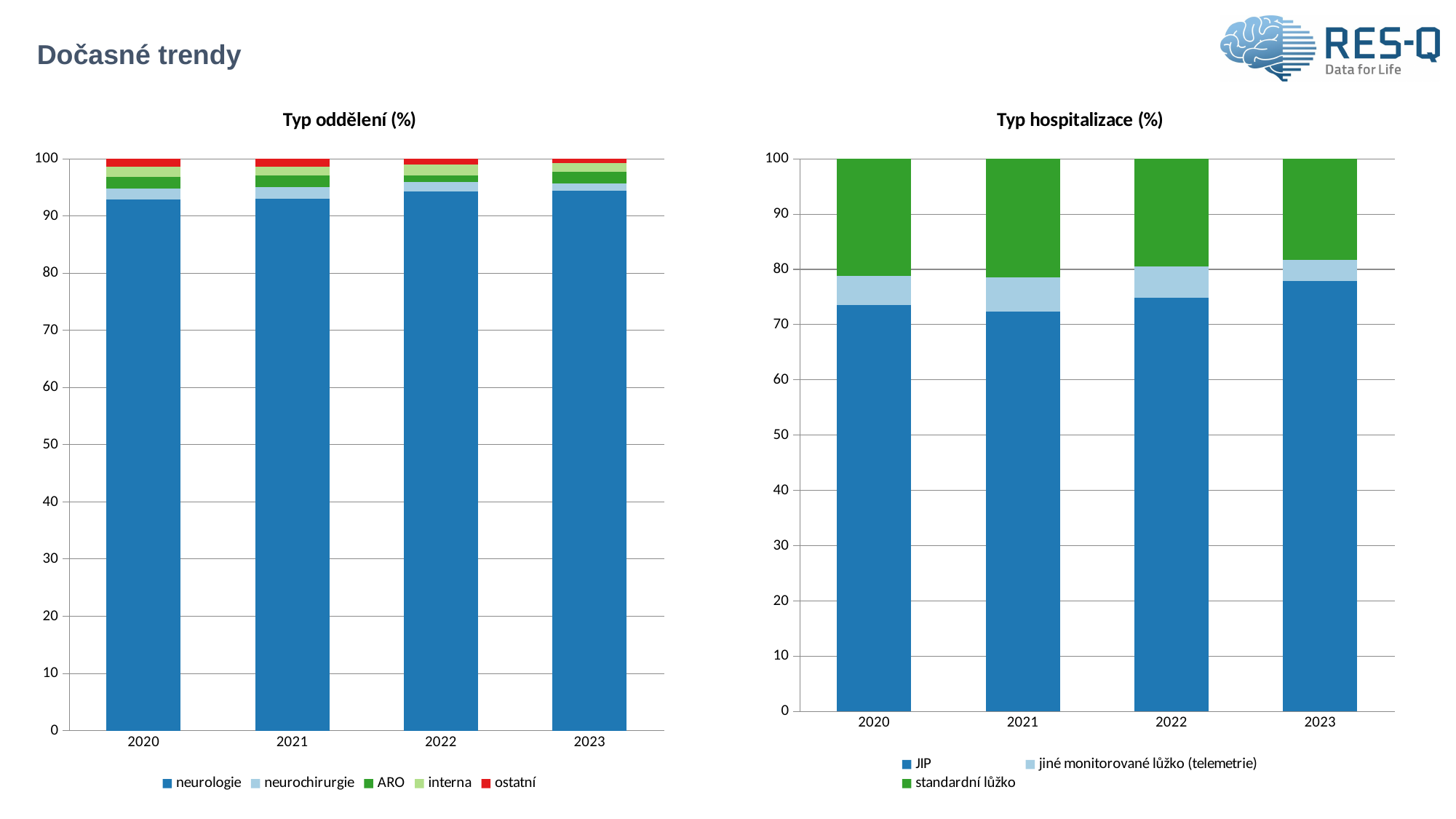
What kind of chart is the 'Typ oddělení (%)' chart on the left? stacked bar chart How many series does the legend of the 'Typ hospitalizace (%)' chart list? 3 How many series does the legend of the 'Typ oddělení (%)' chart list? 5 In the 'Typ hospitalizace (%)' chart, which year has the highest value for JIP? 2023 In the 'Typ hospitalizace (%)' chart, does the JIP value rise or fall from 2021 to 2023? rise In the 'Typ hospitalizace (%)' chart, is the JIP value larger in 2020 or in 2023? 2023 In the 'Typ hospitalizace (%)' chart, is the value for JIP in 2023 greater or less than 80? less In the 'Typ oddělení (%)' chart, is the value for neurologie in 2020 greater or less than 90? greater How many years are shown on the x axis of the 'Typ hospitalizace (%)' chart? 4 In the 'Typ hospitalizace (%)' chart, is the value for JIP in 2021 greater or less than 70? greater Which series is shown in red in the 'Typ oddělení (%)' chart? ostatní In the 'Typ hospitalizace (%)' chart, is the standardní lůžko segment larger in 2020 or in 2023? 2020